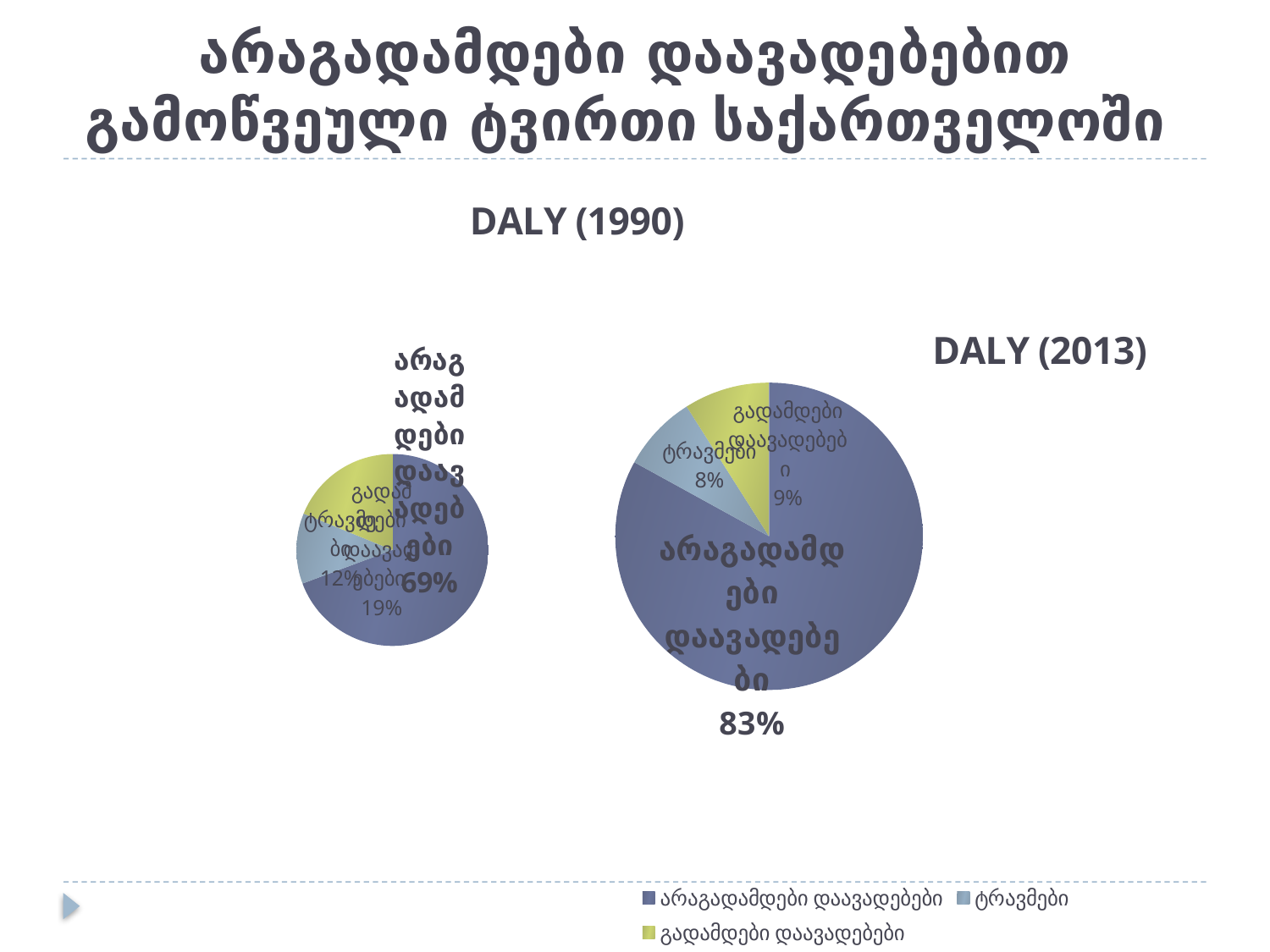
In the DALY (2013) chart, what share does გადამდები დაავადებები have? 9% In the DALY (1990) chart, what share does გადამდები დაავადებები have? 19% What kind of chart is the DALY (1990) chart? pie chart In the DALY (1990) chart, which category has the smallest slice? ტრავმები How many pie charts are on the slide? 2 In the DALY (1990) chart, what share does ტრავმები have? 12% In the DALY (2013) chart, which category has the largest slice? არაგადამდები დაავადებები How many categories does the legend list? 3 What is the difference between the share of არაგადამდები დაავადებები in the DALY (2013) chart and in the DALY (1990) chart? 14 percentage points